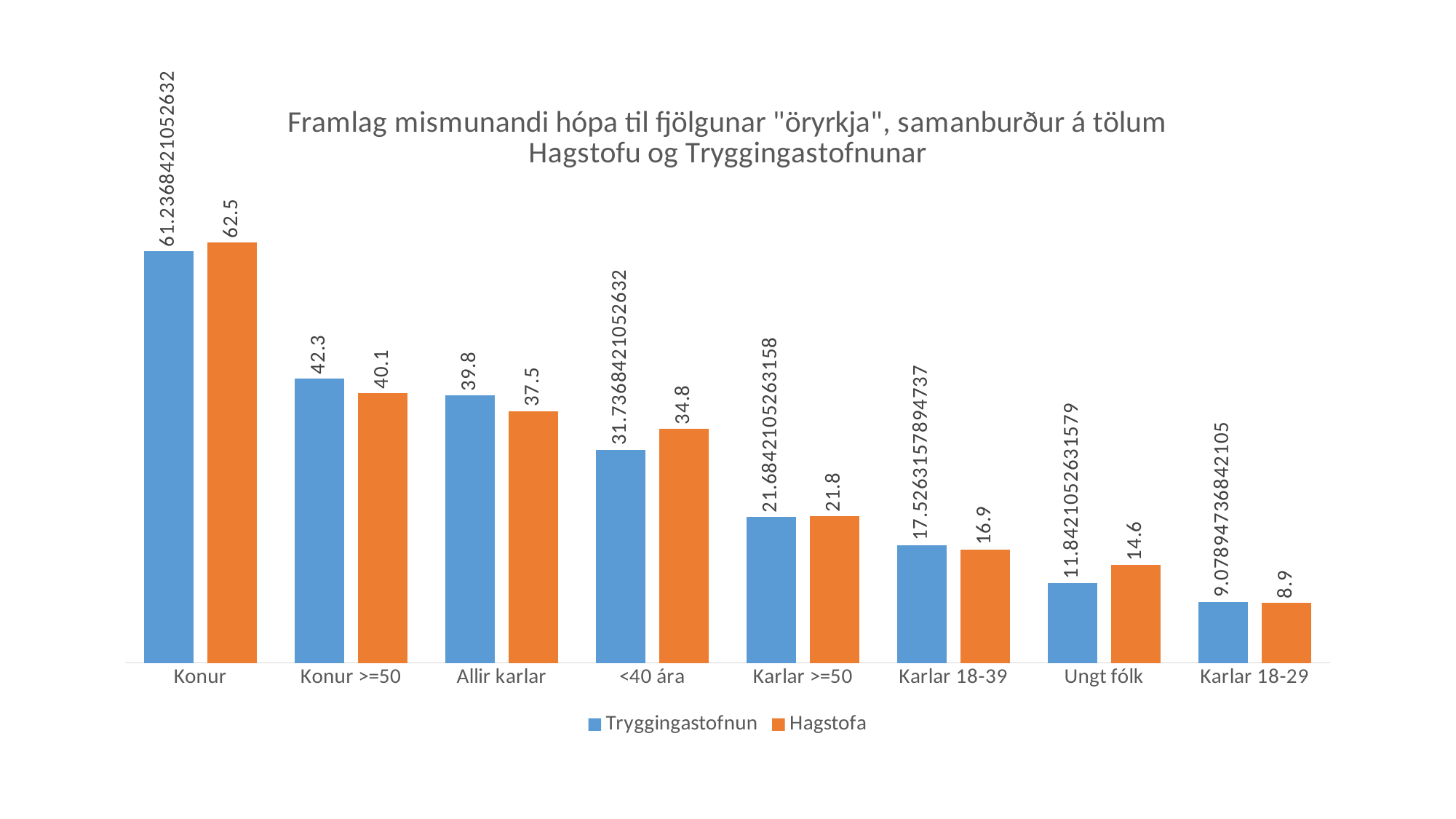
For <40 ára, which series has the larger value, Tryggingastofnun or Hagstofa? Hagstofa What is the difference between the Tryggingastofnun and Hagstofa values for Konur >=50? 2.2 What is the Hagstofa value for Ungt fólk? 14.6 How many series does the legend list? 2 Which category has the lowest Tryggingastofnun value? Karlar 18-29 What is the Tryggingastofnun value for Karlar 18-39? 17.5263157894737 What is the Tryggingastofnun value for Konur >=50? 42.3 What is the Hagstofa value for Konur? 62.5 How many categories are shown on the x axis? 8 Which category has the highest Hagstofa value? Konur What kind of chart is shown on the slide? Bar chart What is the difference between the Tryggingastofnun and Hagstofa values for Allir karlar? 2.3